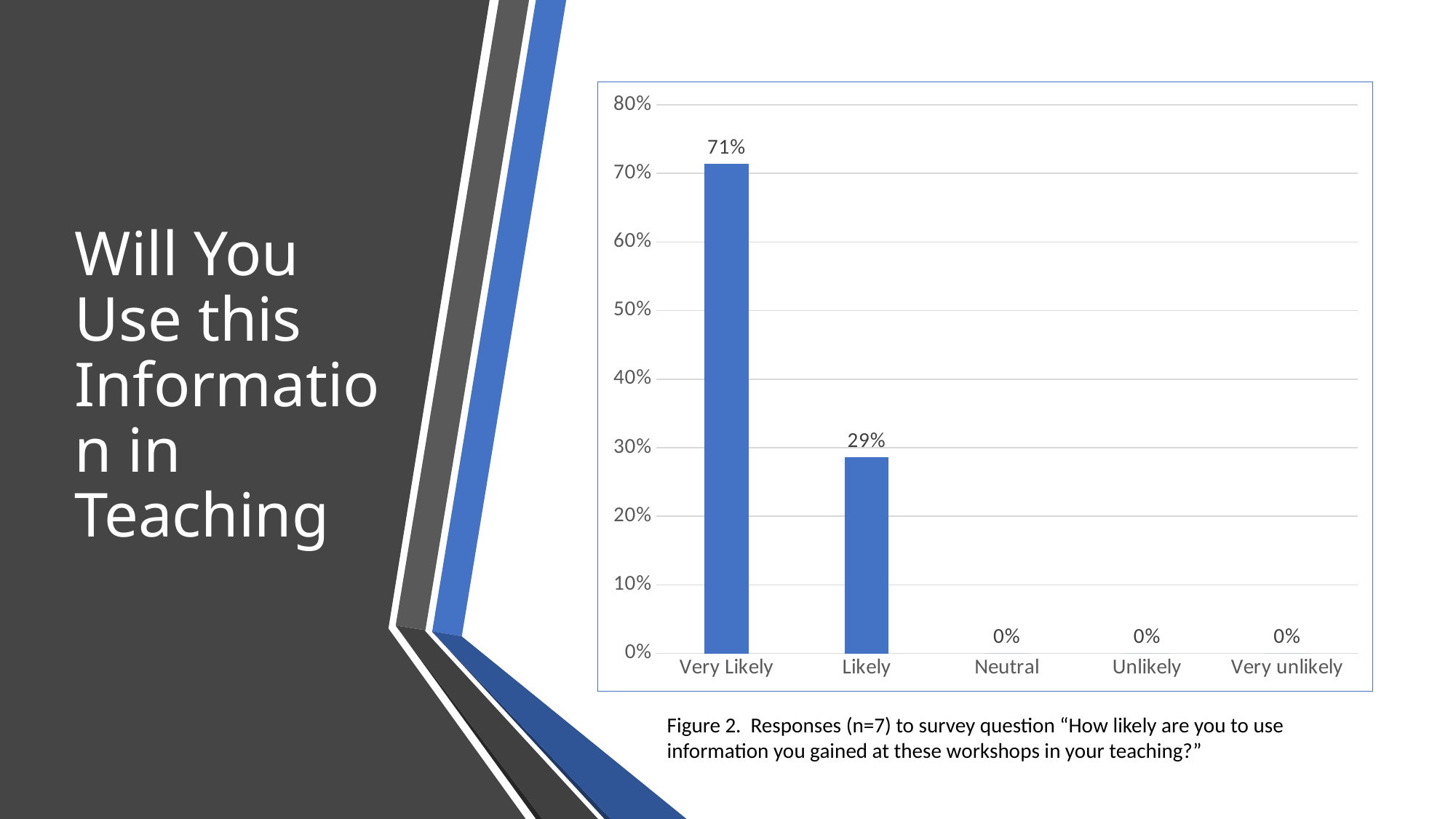
What is the value for Likely? 29% Do the values rise or fall from Very Likely to Likely along the x axis? fall Which is larger, the value for Likely or the value for Very Likely? Very Likely How many categories are shown on the x axis? 5 Which category has the highest value? Very Likely What is the difference between the values for Very Likely and Likely? 42% What is the value for Very unlikely? 0% What is the value for Very Likely? 71% What kind of chart is shown on the slide? bar chart What is the highest value shown on the y axis? 80% What is the value for Neutral? 0% Is the value for Likely greater or less than 40%? less